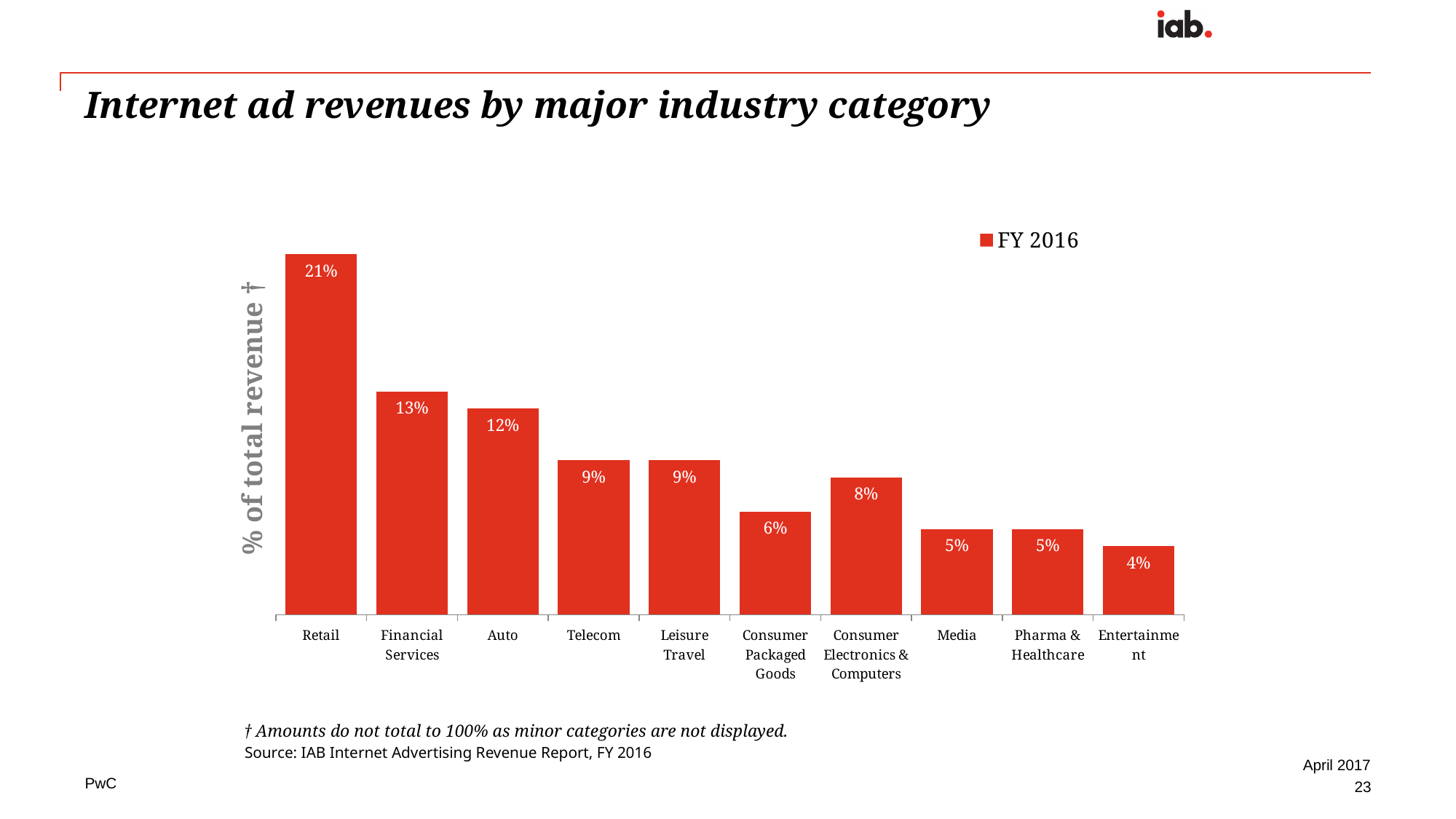
What share of total revenue does Retail account for? 21% Which is larger, the value for Financial Services or the value for Auto? Financial Services What kind of chart is shown on the slide? Bar chart What is the difference between the values for Auto and Consumer Packaged Goods? 6% What is the difference between the values for Retail and Financial Services? 8% Which industry category has the highest share of total revenue? Retail What is the value for Entertainment? 4% Which industry category has the lowest share of total revenue? Entertainment What is the value for Consumer Electronics & Computers? 8% How many industry categories are shown in the chart? 10 What series name is shown in the legend? FY 2016 How many series does the legend list? 1